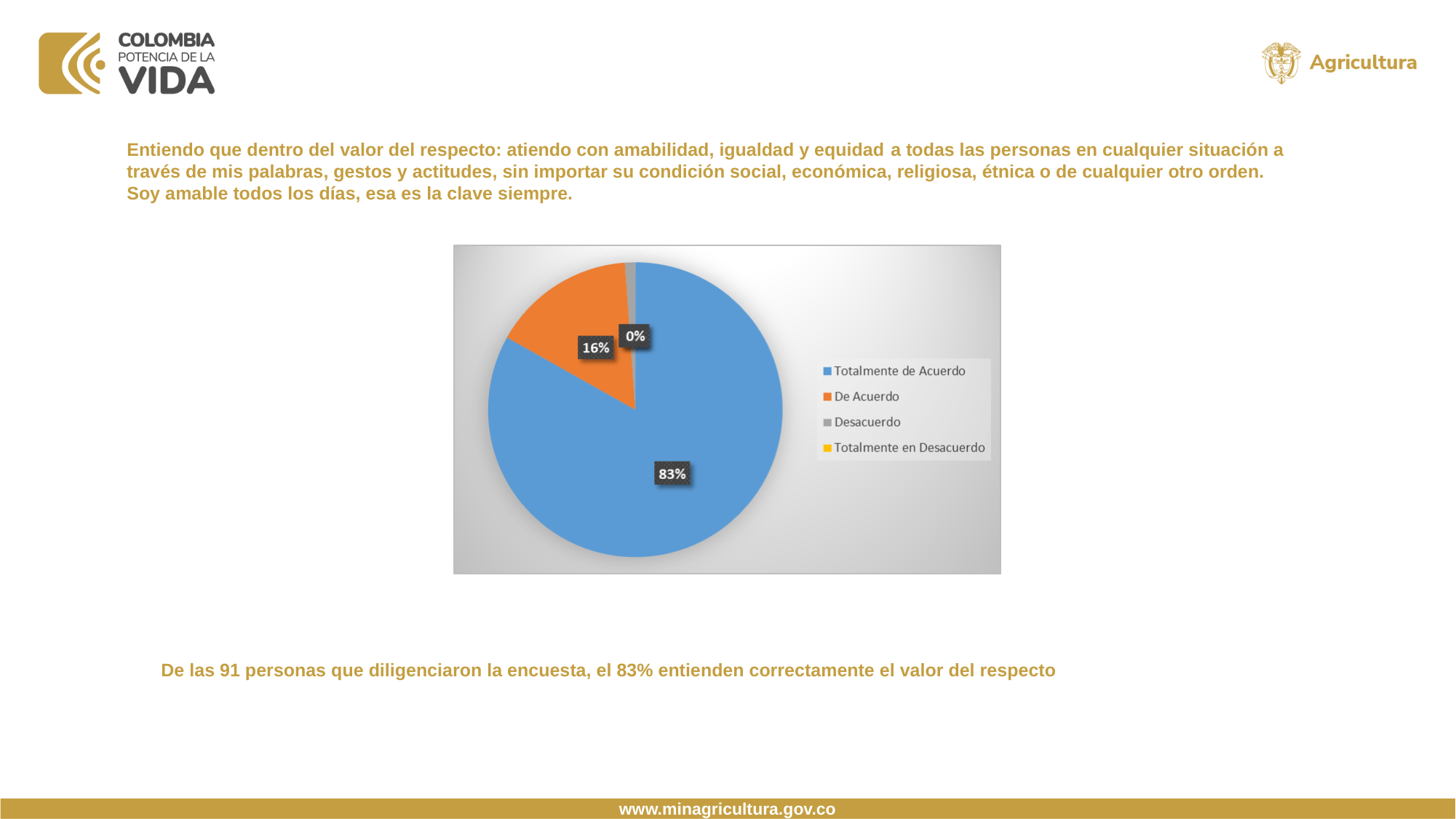
What share of the pie does "Totalmente de Acuerdo" represent? 83% Which is larger, the slice for "Totalmente de Acuerdo" or the slice for "De Acuerdo"? Totalmente de Acuerdo What is the value shown for "De Acuerdo"? 16% How many categories does the legend list? 4 Which category has the largest slice of the pie? Totalmente de Acuerdo What kind of chart is shown on the slide? pie chart What is the value shown for "Desacuerdo"? 0% What colour is the slice for "Totalmente de Acuerdo"? blue What colour is the slice for "De Acuerdo"? orange What is the difference in percentage points between "Totalmente de Acuerdo" and "De Acuerdo"? 67